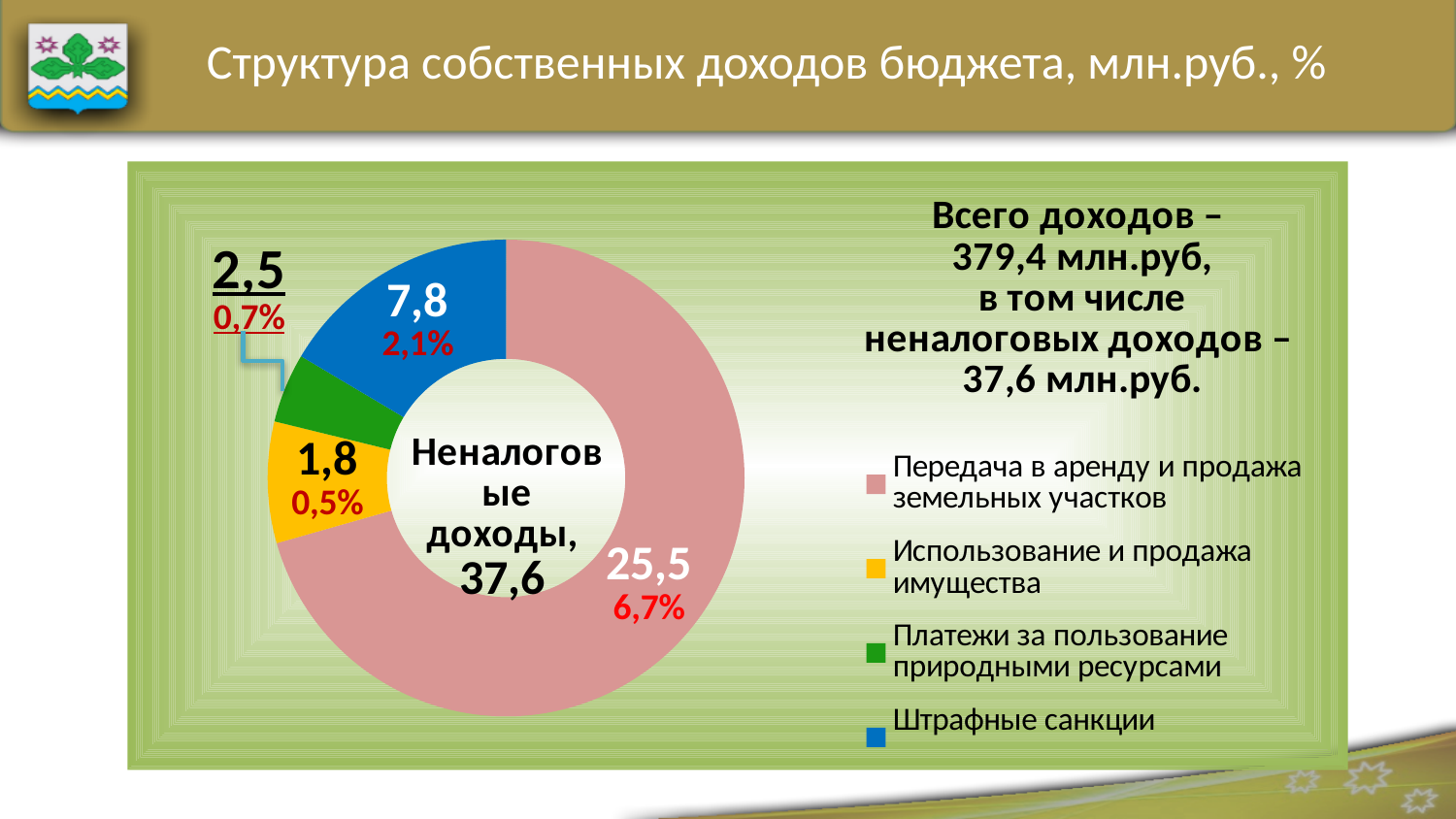
Which is larger: Штрафные санкции or Платежи за пользование природными ресурсами? Штрафные санкции How many categories does the legend list? 4 What is the value (млн.руб.) for Штрафные санкции? 7,8 What total value is shown in the centre of the doughnut chart? 37,6 What is the difference in млн.руб. between Передача в аренду и продажа земельных участков and Штрафные санкции? 17,7 What kind of chart is shown on the slide? Doughnut (pie) chart What is the value (млн.руб.) for Использование и продажа имущества? 1,8 Which category has the largest slice of the chart? Передача в аренду и продажа земельных участков What is the value (млн.руб.) for Платежи за пользование природными ресурсами? 2,5 What is the value (млн.руб.) for Передача в аренду и продажа земельных участков? 25,5 What percentage is shown next to the Штрафные санкции slice? 2,1%